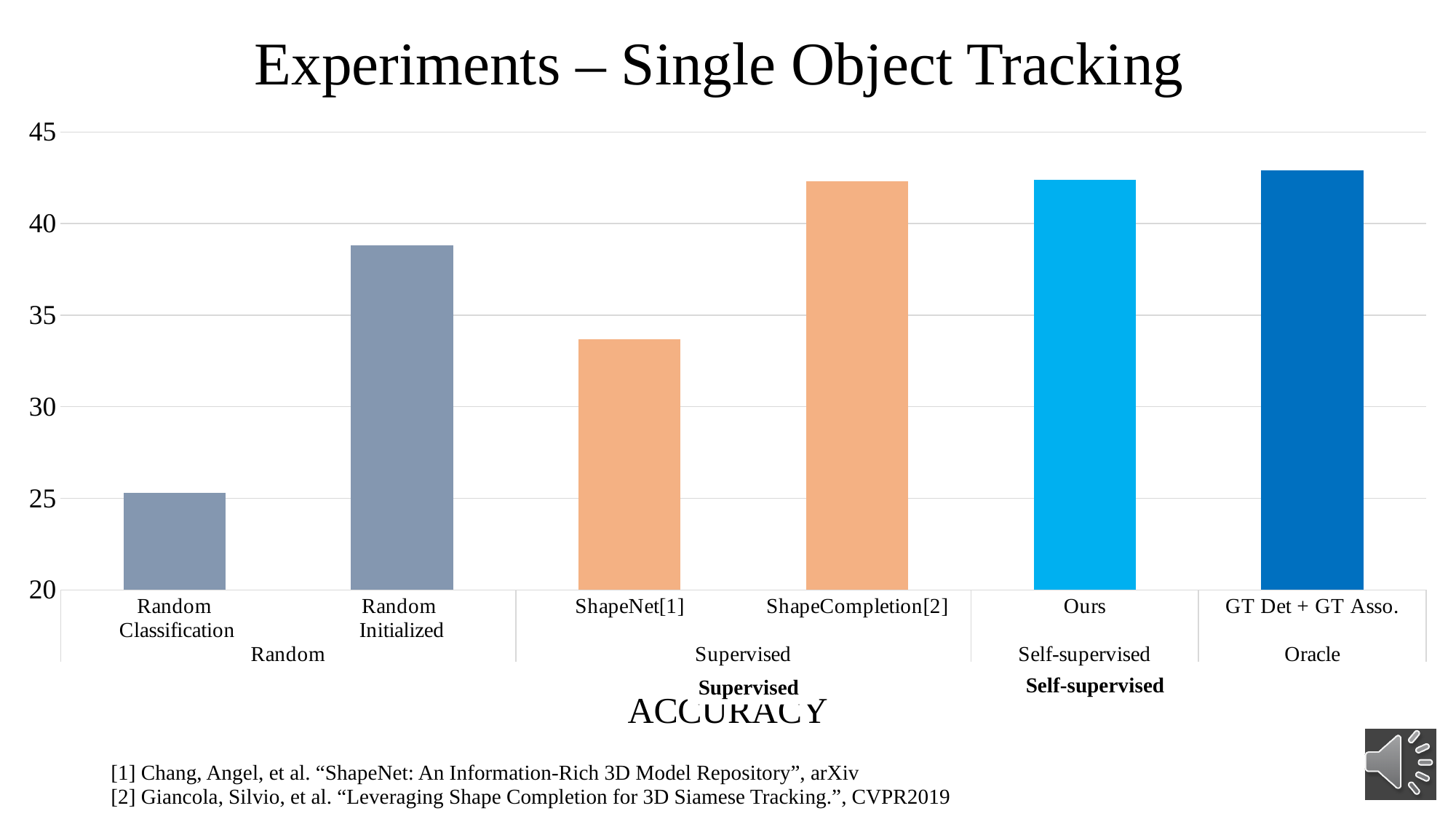
Is the value for Ours greater or less than 40? greater What is the title of the slide containing the chart? Experiments – Single Object Tracking What kind of chart is shown on the slide? bar chart Which is larger, the value for Random Initialized or the value for ShapeNet[1]? Random Initialized Is the value for Random Initialized greater or less than 40? less Is the value for ShapeCompletion[2] greater or less than 40? greater Which is larger, the value for ShapeCompletion[2] or the value for ShapeNet[1]? ShapeCompletion[2] Which category has the lowest bar in the chart? Random Classification Which group label on the x axis contains the bars ShapeNet[1] and ShapeCompletion[2]? Supervised How many bars are plotted in the chart? 6